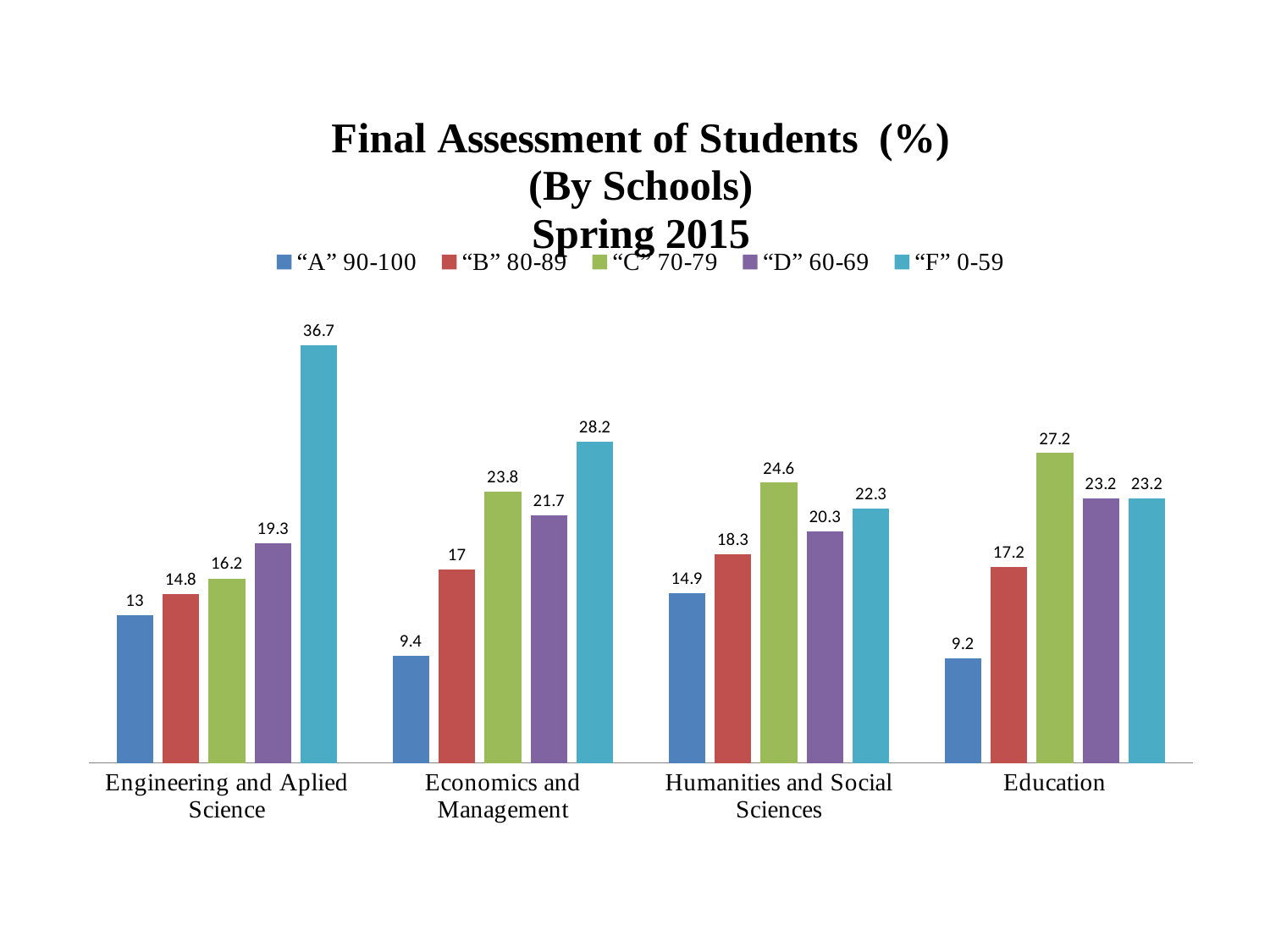
What is the value for "F" 0-59 in Engineering and Applied Science? 36.7 What is the value for "D" 60-69 in Humanities and Social Sciences? 20.3 What is the value for "C" 70-79 in Education? 27.2 Which is larger for Economics and Management: the "C" 70-79 value or the "D" 60-69 value? "C" 70-79 What is the value for "A" 90-100 in Economics and Management? 9.4 What is the title of the chart? Final Assessment of Students (%) (By Schools) Spring 2015 How many series does the legend list? 5 What is the difference between the "F" 0-59 value and the "A" 90-100 value for Engineering and Applied Science? 23.7 How many schools are shown on the x axis? 4 What kind of chart is shown on the slide? Bar chart Which school has the highest value for "F" 0-59? Engineering and Applied Science Which school has the lowest value for "A" 90-100? Education